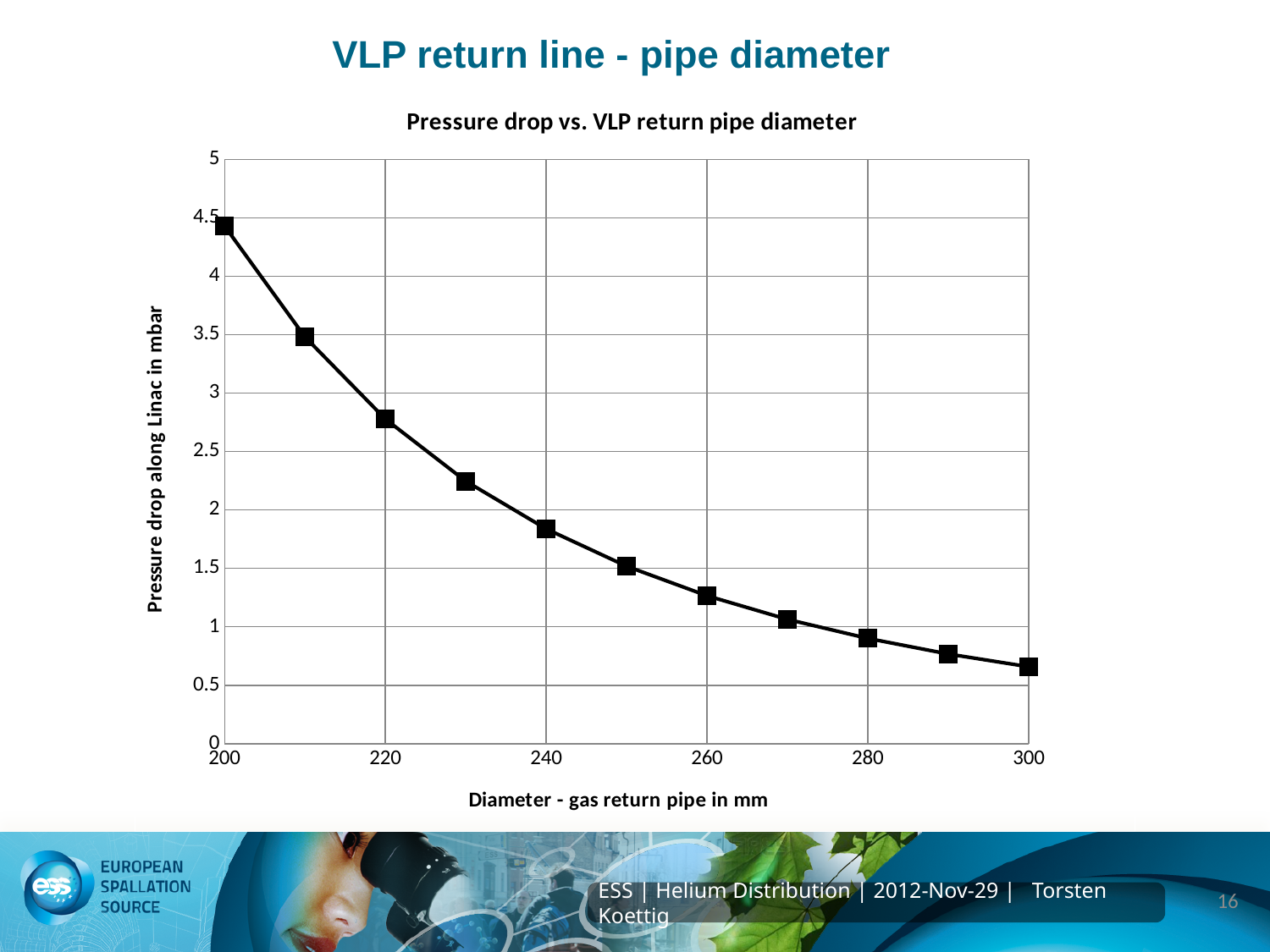
At which pipe diameter is the pressure drop highest? 200 Is the pressure drop at a diameter of 240 mm greater or less than 2? less Is the pressure drop at a diameter of 260 mm greater or less than 1? greater What is the label of the y axis? Pressure drop along Linac in mbar Is the pressure drop at a diameter of 300 mm greater or less than 1? less What kind of chart is shown on the slide? line chart Does the pressure drop rise or fall as the pipe diameter increases? fall What is the title of the chart? Pressure drop vs. VLP return pipe diameter How many data points are plotted on the chart? 11 At which pipe diameter is the pressure drop lowest? 300